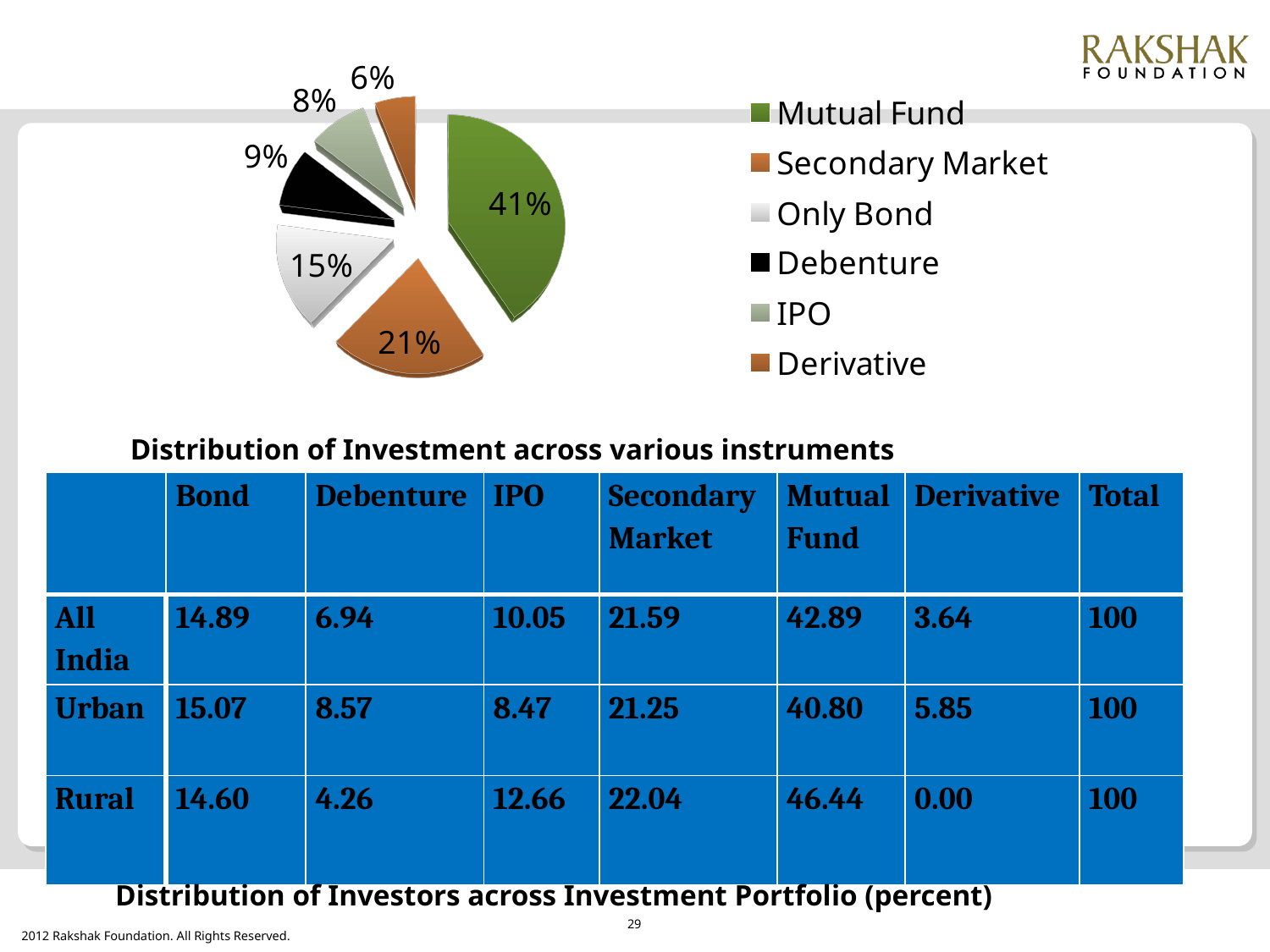
Which slice is larger, IPO or Only Bond? Only Bond What share of the pie does Derivative account for? 6% Which category has the smallest slice of the pie? Derivative What kind of chart is shown on the slide? pie chart How many categories does the pie chart legend list? 6 What is the difference in percentage points between the Mutual Fund slice and the Secondary Market slice? 20 What is the title shown beneath the pie chart? Distribution of Investment across various instruments Which category has the largest slice of the pie? Mutual Fund What share of the pie does Only Bond account for? 15% What share of the pie does Debenture account for? 9%